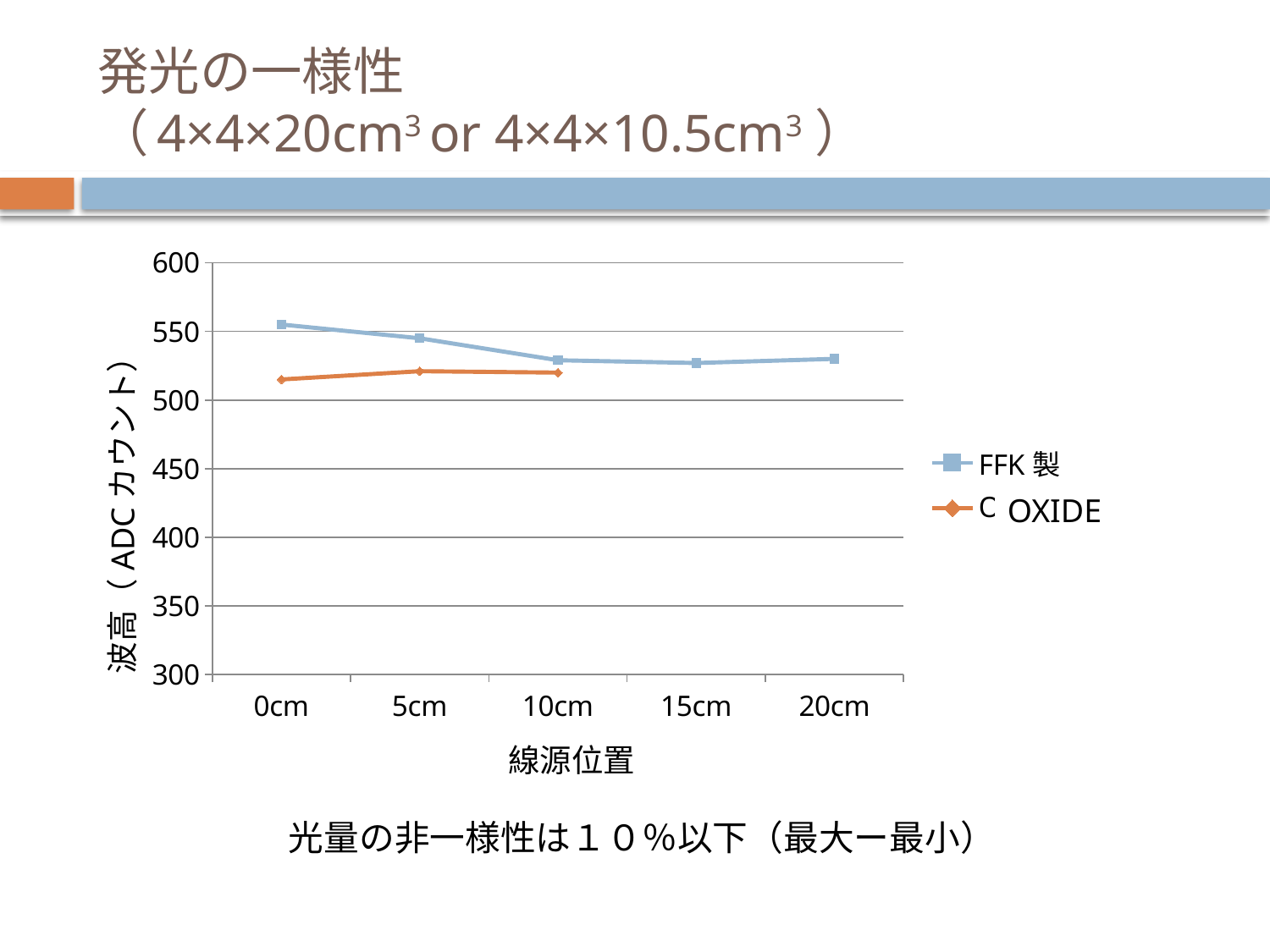
Is the value for C OXIDE at 0cm greater or less than 500? greater How many source positions are labelled on the x axis? 5 Is the value for C OXIDE at 5cm greater or less than 550? less What is the title of the y axis? 波高（ADCカウント） What kind of chart is shown on the slide? line chart Does the FFK製 series rise or fall from 0cm to 10cm? fall At which source position is the FFK製 series highest? 0cm What is the title of the x axis? 線源位置 Which series has the higher value at 0cm, FFK製 or C OXIDE? FFK製 Is the value for FFK製 at 10cm greater or less than 550? less How many series does the legend list? 2